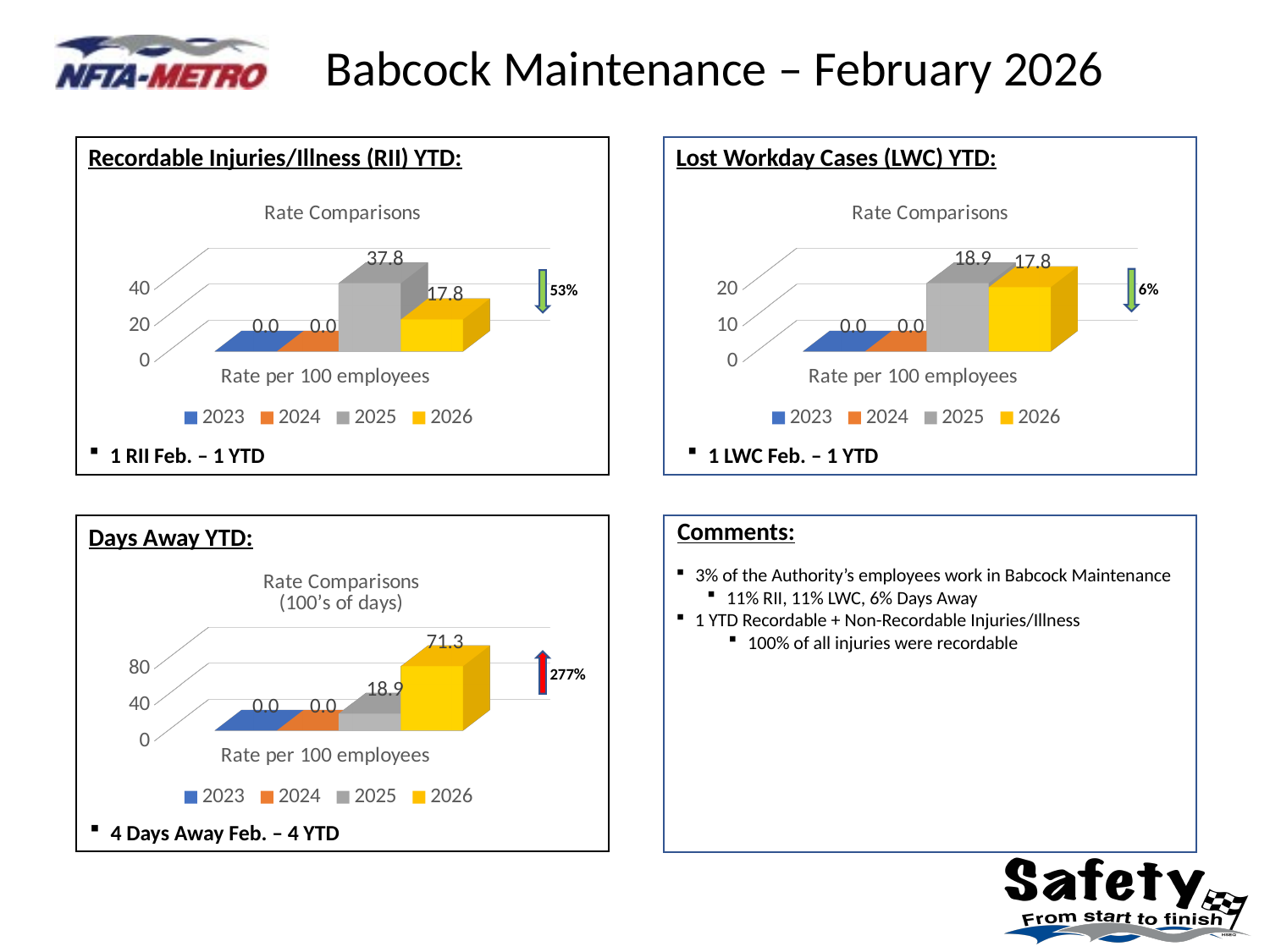
In the Days Away YTD chart, what is the value for 2026? 71.3 In the Recordable Injuries/Illness (RII) YTD chart, which year has the highest value? 2025 In the Lost Workday Cases (LWC) YTD chart, what is the value for 2025? 18.9 In the Days Away YTD chart, what is the difference between the 2026 and 2025 values? 52.4 In the Days Away YTD chart, which year has the highest value? 2026 In the Lost Workday Cases (LWC) YTD chart, what is the value for 2023? 0.0 In the Lost Workday Cases (LWC) YTD chart, what is the value for 2026? 17.8 What kind of chart is the Recordable Injuries/Illness (RII) YTD chart? Bar chart How many series does the legend list in the Days Away YTD chart? 4 In the Recordable Injuries/Illness (RII) YTD chart, what is the value for 2026? 17.8 In the Recordable Injuries/Illness (RII) YTD chart, what is the difference between the 2025 and 2026 values? 20.0 In the Recordable Injuries/Illness (RII) YTD chart, what is the value for 2025? 37.8